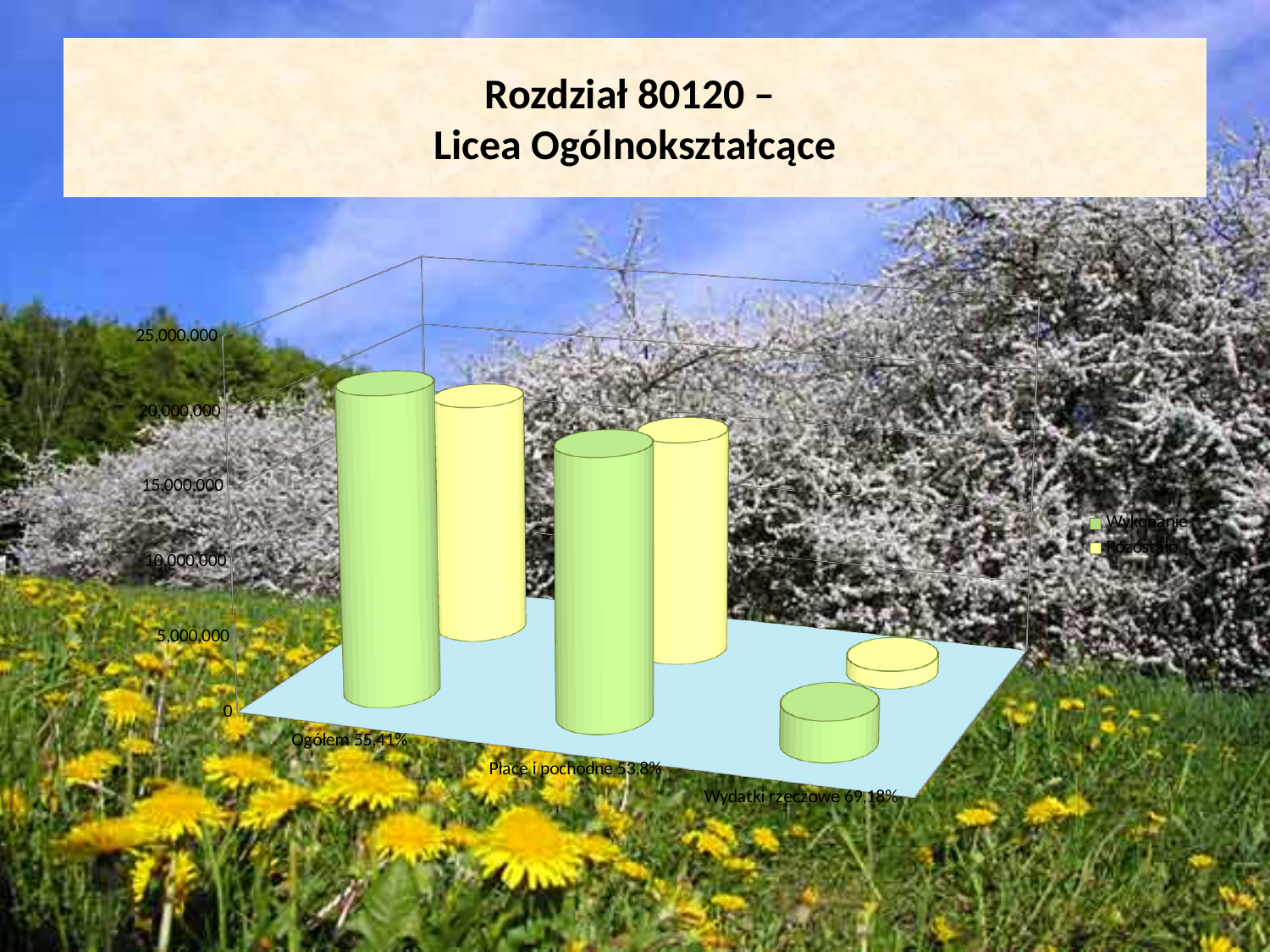
Which is larger: the Wykonanie value for Ogółem or the Wykonanie value for Wydatki rzeczowe? Ogółem How many series does the chart legend list? 2 Is the Wykonanie value for Wydatki rzeczowe greater or less than 5,000,000? less What is the highest value shown on the vertical axis of the chart? 25,000,000 What type of chart is shown on the slide? bar chart How many categories are shown on the x axis of the chart? 3 What are the two series named in the chart legend? Wykonanie and Pozostało Which category has the highest Wykonanie value? Ogółem 55,41% Is the Wykonanie value for Ogółem greater or less than 10,000,000? greater What is the title of the slide containing the chart? Rozdział 80120 – Licea Ogólnokształcące Which category has the lowest Pozostało value? Wydatki rzeczowe 69,18% Which category has the lowest Wykonanie value? Wydatki rzeczowe 69,18%